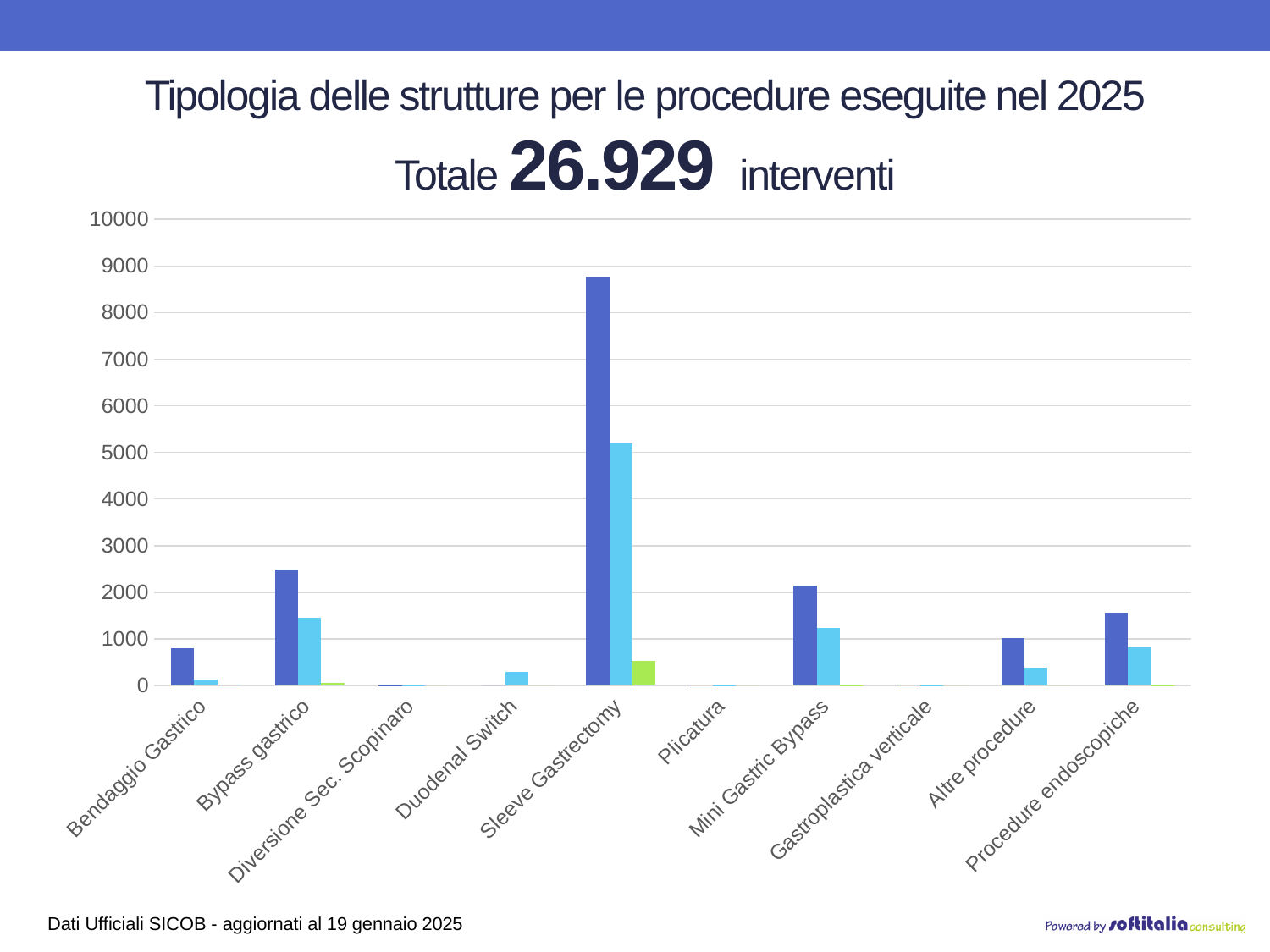
Is the dark blue bar for Procedure endoscopiche greater or less than 1000? greater Which procedure category has the tallest bar in the chart? Sleeve Gastrectomy Is the dark blue bar for Bendaggio Gastrico greater or less than 1000? less Which has a taller dark blue bar, Mini Gastric Bypass or Altre procedure? Mini Gastric Bypass How many procedure categories are shown on the x axis of the chart? 10 Is the light blue bar for Sleeve Gastrectomy greater or less than 5000? greater Which has a taller dark blue bar, Bypass gastrico or Bendaggio Gastrico? Bypass gastrico What total number of interventions is stated in the chart title? 26.929 What kind of chart is shown on the slide? bar chart